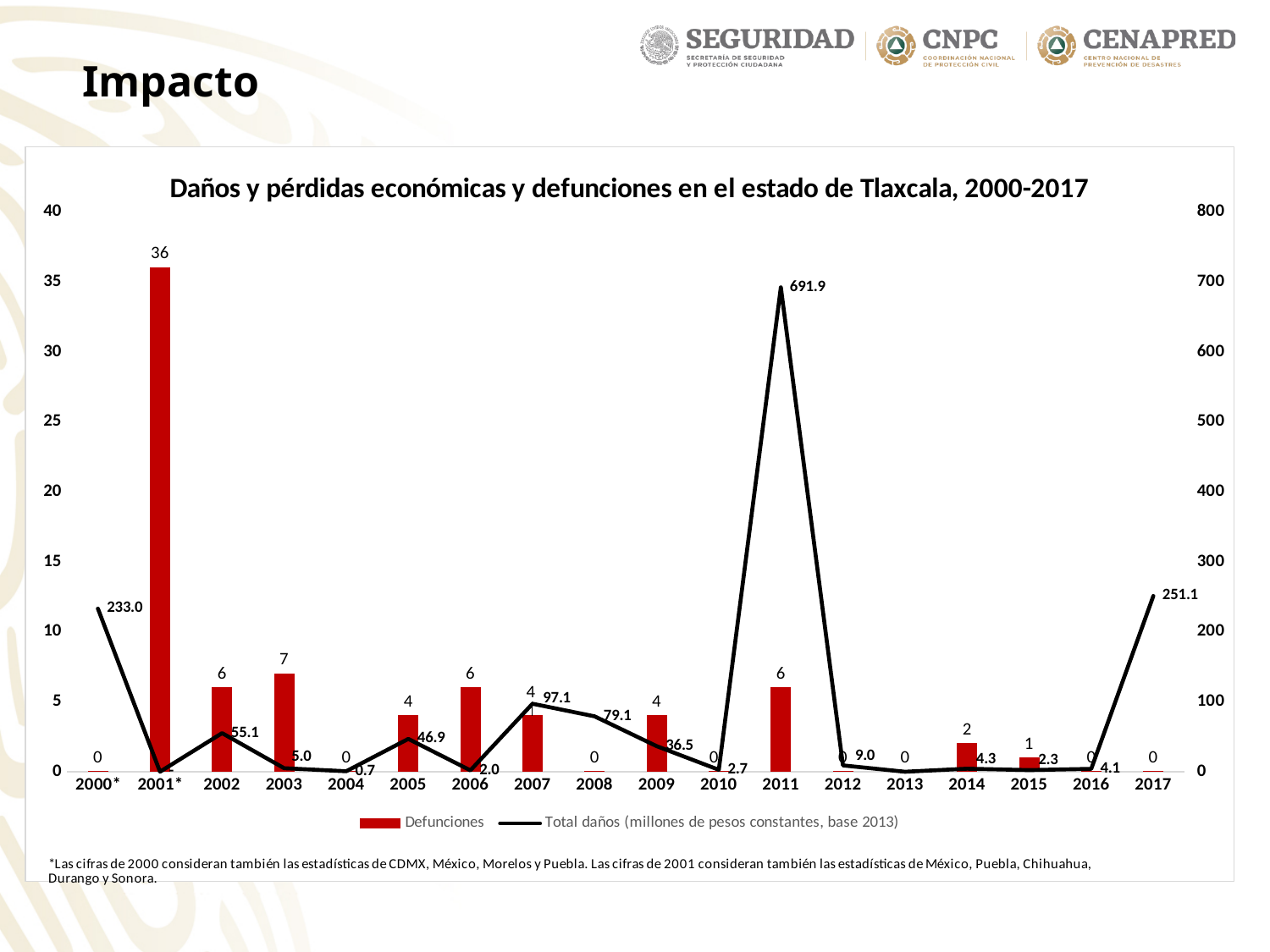
How many series does the legend list? 2 What is the title of the chart? Daños y pérdidas económicas y defunciones en el estado de Tlaxcala, 2000-2017 How many years are shown on the x axis? 18 What is the value of Total daños (millones de pesos constantes, base 2013) for 2011? 691.9 What is the value of Total daños for 2017? 251.1 Which year has the highest value of Total daños? 2011 What is the value of Defunciones for 2014? 2 What is the value of Defunciones for 2001*? 36 What is the difference between the Total daños values for 2011 and 2017? 440.8 What is the difference in Defunciones between 2003 and 2002? 1 Which is larger, the Total daños value for 2007 or for 2008? 2007 Which year has the highest value of Defunciones? 2001*